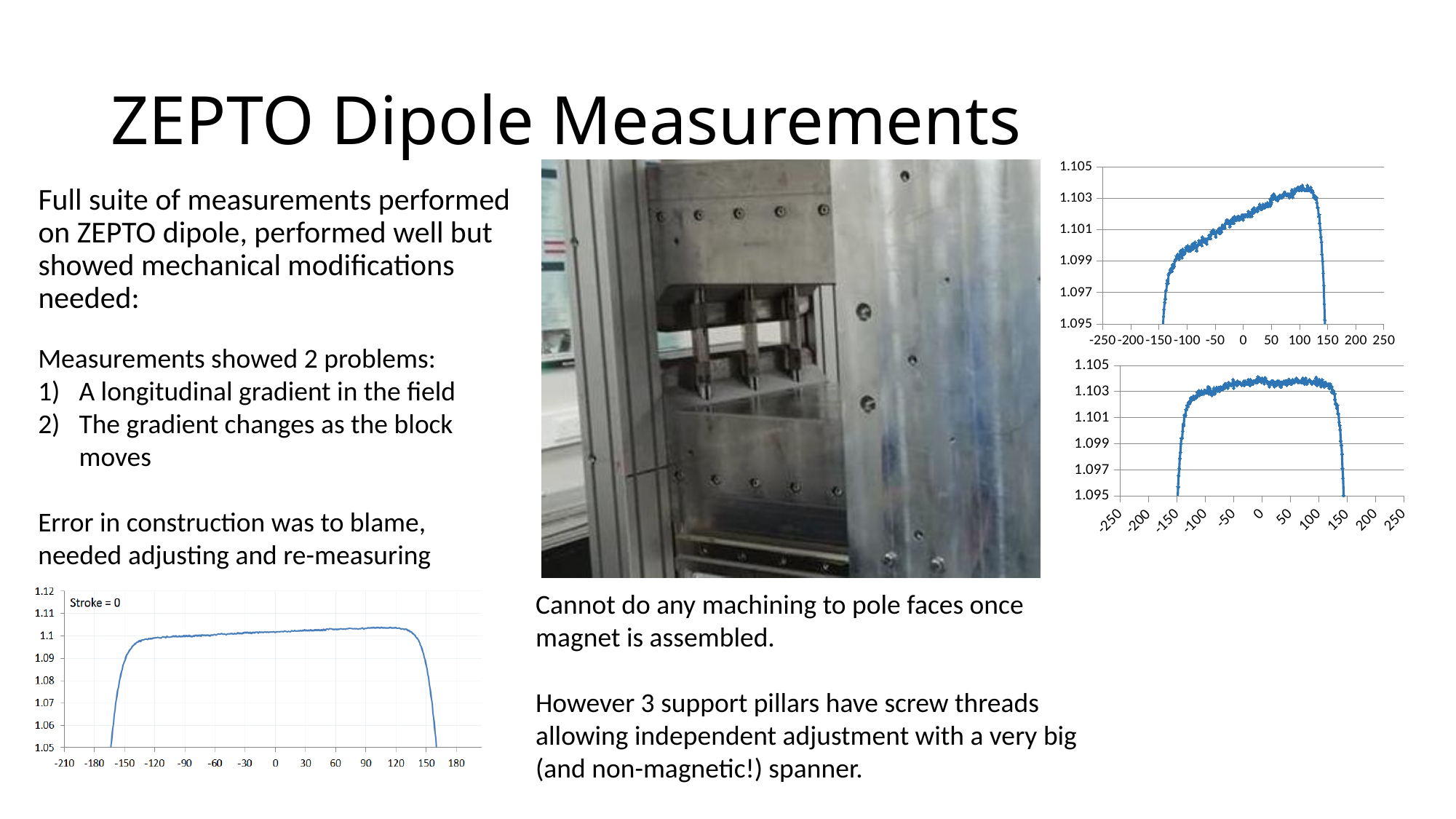
What is the highest value shown on the y axis of the bottom-left chart? 1.12 What kind of chart is the top-right chart on the slide? line chart In the top-right chart, is the value at x = -100 greater or less than 1.101? less In the top-right chart, is the value at x = 0 greater or less than 1.099? greater In the top-right chart, which is larger: the value at x = 100 or the value at x = -100? x = 100 In the middle-right chart (the second chart on the right), is the value at x = 0 greater or less than 1.101? greater In the top-right chart, does the plotted value rise or fall as x goes from -150 to 100? rise What text label appears inside the plot area of the bottom-left chart? Stroke = 0 How many charts are shown on the slide? 3 In the middle-right chart (the second chart on the right), does the plotted value rise, fall, or stay roughly flat between x = -100 and x = 100? roughly flat